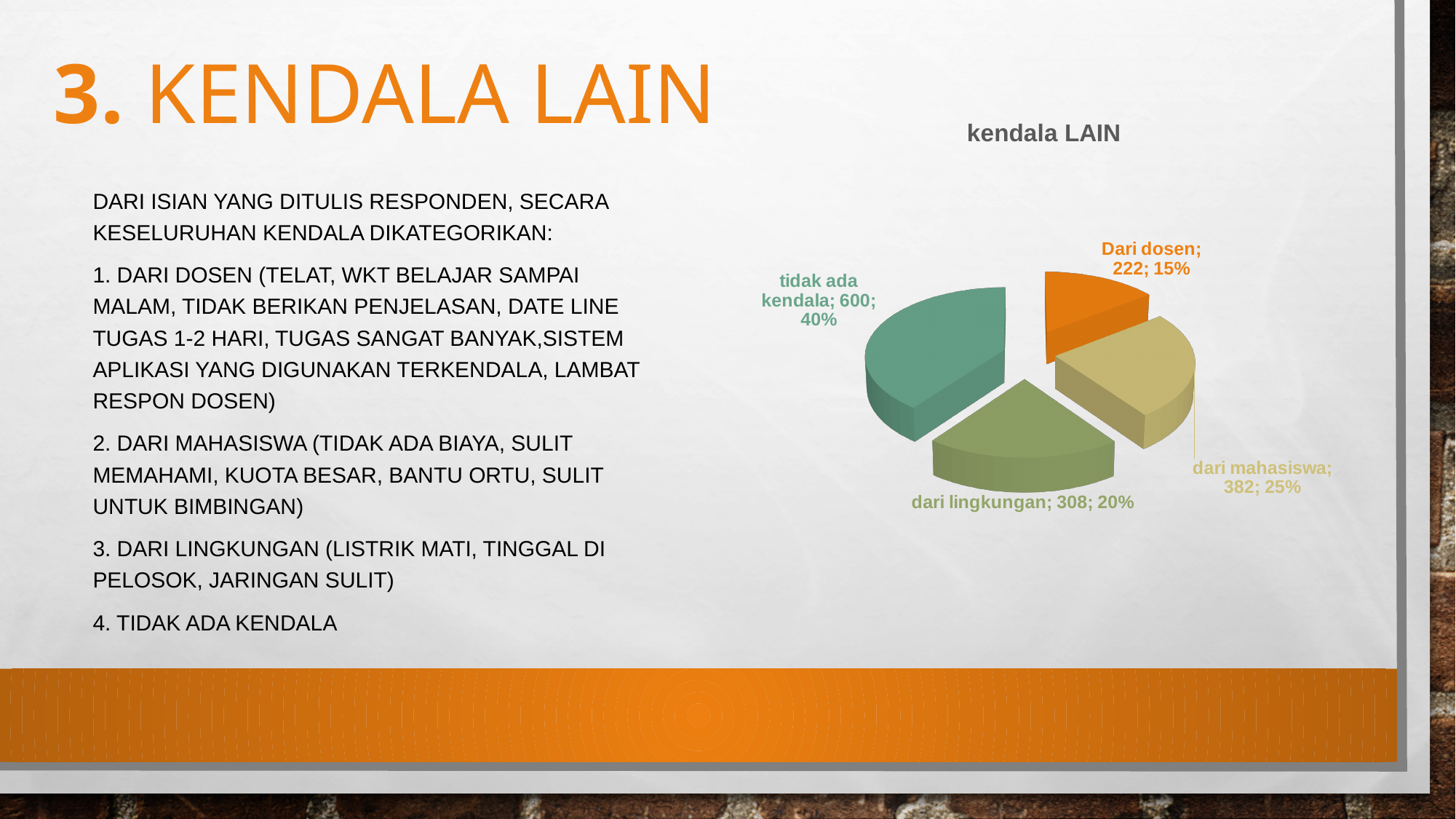
Which is larger, the value for 'dari mahasiswa' or the value for 'dari lingkungan'? dari mahasiswa How many slices does the pie chart have? 4 What is the difference between the values for 'tidak ada kendala' and 'dari lingkungan'? 292 Which category has the largest slice? tidak ada kendala What is the value for 'dari mahasiswa'? 382 What is the value for 'Dari dosen'? 222 What is the value for 'tidak ada kendala'? 600 What is the title of the chart? kendala LAIN What kind of chart is shown on the slide? pie chart What share of the pie does 'dari mahasiswa' represent? 25% Which category has the smallest slice? Dari dosen What is the value for 'dari lingkungan'? 308